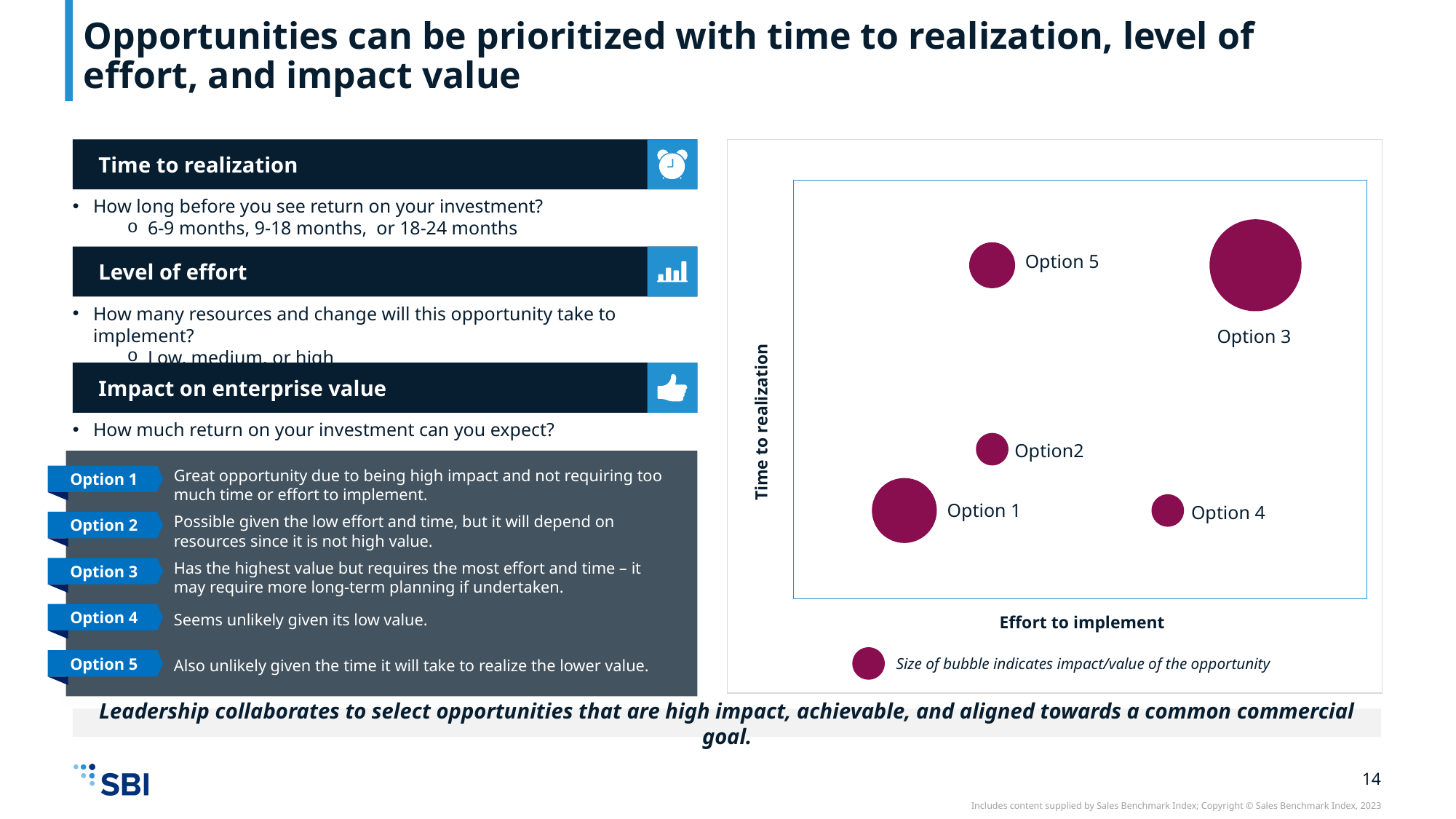
Which option is positioned furthest to the right on the effort to implement axis? Option 3 What is the label of the horizontal axis of the chart? Effort to implement How many options are plotted as bubbles in the chart? 5 Which option has a higher time to realization, Option 2 or Option 5? Option 5 Which option is positioned furthest to the left on the effort to implement axis? Option 1 Which bubble is larger, Option 1 or Option 2? Option 1 What kind of chart is shown on the right side of the slide? Bubble chart Which bubble is larger, Option 3 or Option 5? Option 3 Which option has the largest bubble in the chart? Option 3 According to the chart's note, what does the size of a bubble indicate? Impact/value of the opportunity